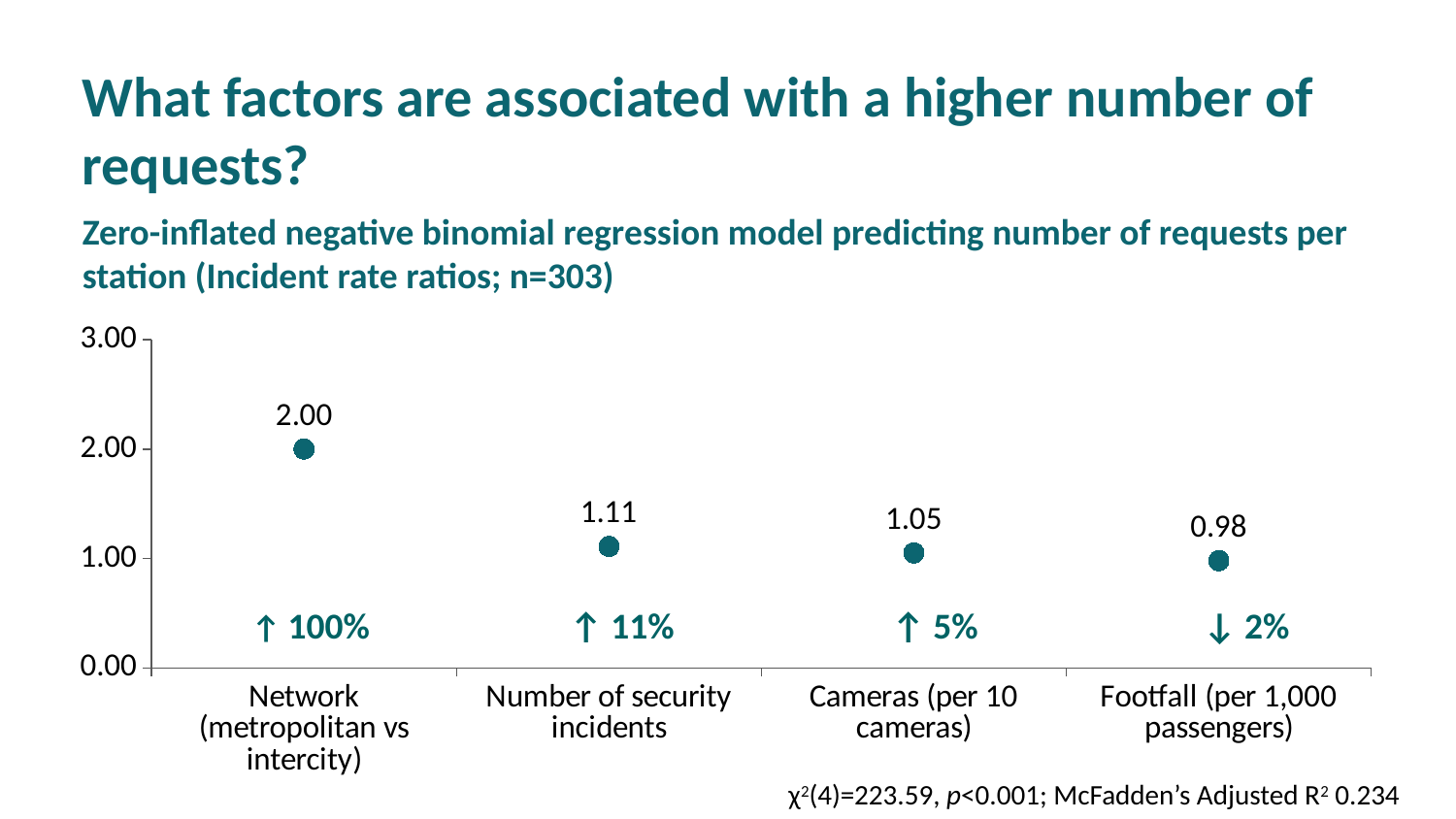
What is the incident rate ratio for Network (metropolitan vs intercity)? 2.00 Is the value for Footfall (per 1,000 passengers) greater or less than 1.00? less What is the difference between the incident rate ratios for Network (metropolitan vs intercity) and Number of security incidents? 0.89 How many factors are plotted on the chart? 4 Which factor has the lowest incident rate ratio? Footfall (per 1,000 passengers) What percentage change is annotated for Cameras (per 10 cameras)? ↑ 5% What is the incident rate ratio for Number of security incidents? 1.11 Which factor has the highest incident rate ratio? Network (metropolitan vs intercity) What is the incident rate ratio for Cameras (per 10 cameras)? 1.05 What is the incident rate ratio for Footfall (per 1,000 passengers)? 0.98 Which has a larger incident rate ratio, Number of security incidents or Cameras (per 10 cameras)? Number of security incidents What is the maximum value shown on the vertical axis? 3.00